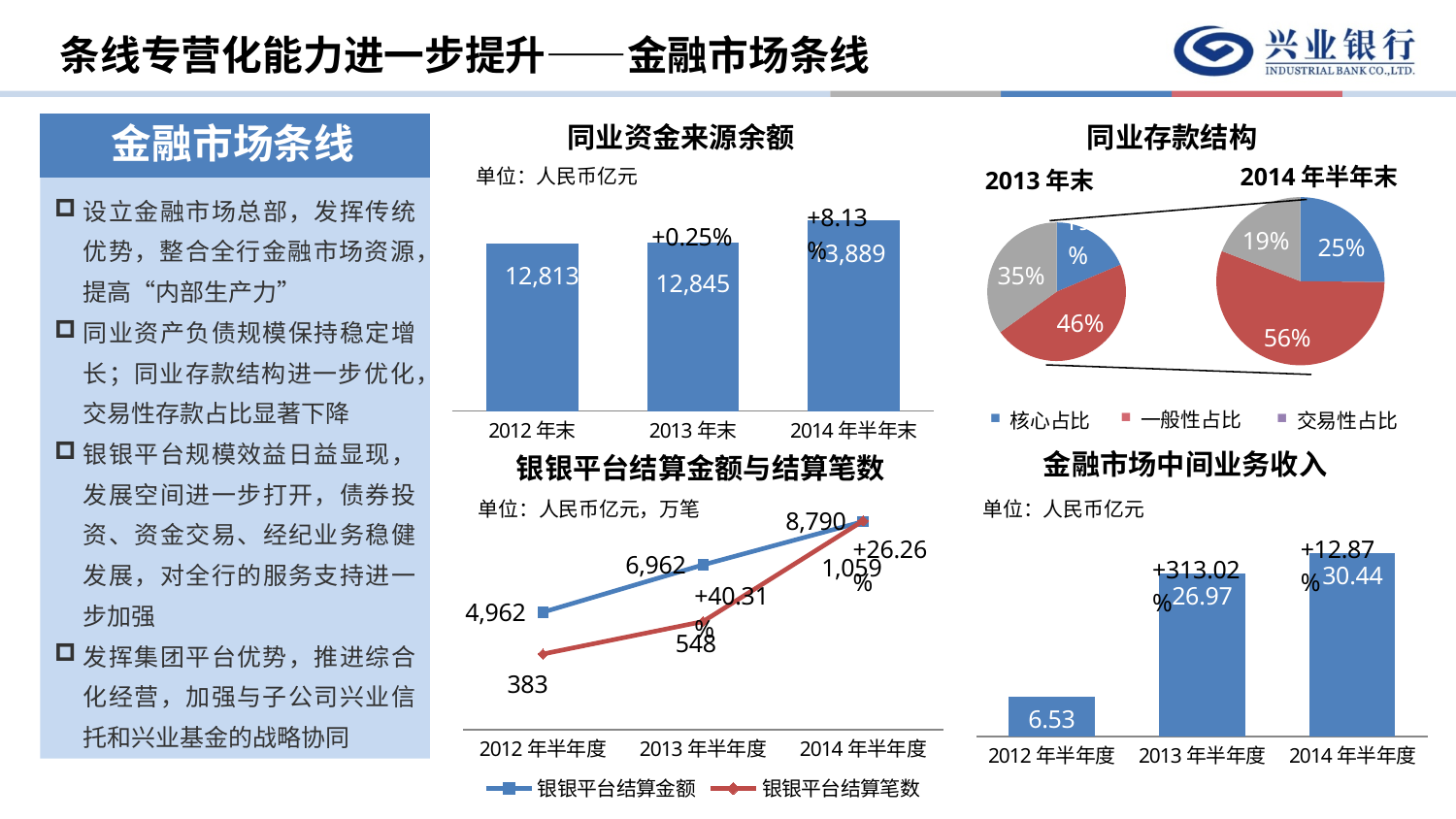
In the 同业资金来源余额 chart, which period has the highest value? 2014年半年末 In the 同业资金来源余额 chart, what is the value for 2013年末? 12,845 In the 银银平台结算金额与结算笔数 chart, what is the difference between the 银银平台结算金额 values for 2013年半年度 and 2012年半年度? 2,000 In the 同业资金来源余额 chart, what is the value for 2012年末? 12,813 In the 同业存款结构 chart, what is the 核心占比 share in the 2014年半年末 pie? 25% In the 同业资金来源余额 chart, what is the growth rate shown above the 2013年末 bar? +0.25% In the 同业存款结构 chart, what is the 一般性占比 share in the 2014年半年末 pie? 56% In the 金融市场中间业务收入 chart, what is the value for 2012年半年度? 6.53 In the 银银平台结算金额与结算笔数 chart, what is the 银银平台结算笔数 value for 2012年半年度? 383 In the 金融市场中间业务收入 chart, what is the difference between the 2014年半年度 and 2013年半年度 values? 3.47 In the 同业存款结构 chart, how many categories does the legend list? 3 In the 银银平台结算金额与结算笔数 chart, what is the 银银平台结算金额 value for 2014年半年度? 8,790